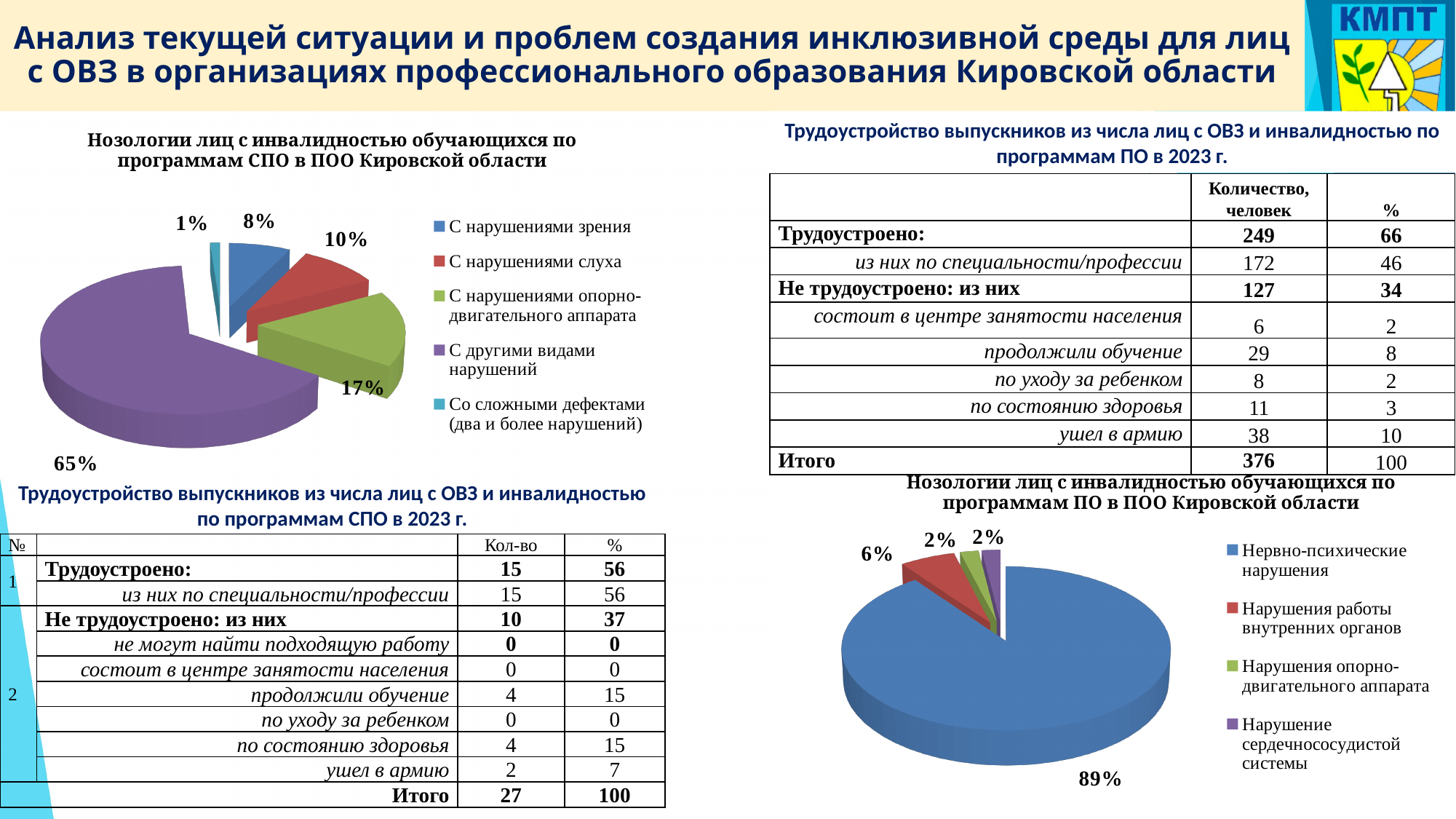
In the pie chart on nosologies of students in СПО programmes (left chart), which category has the largest share? С другими видами нарушений In the pie chart on nosologies of students in ПО programmes (bottom right chart), what share is shown for 'Нарушения работы внутренних органов'? 6% In the pie chart on nosologies of students in СПО programmes (left chart), which is larger: 'С нарушениями слуха' or 'С нарушениями опорно-двигательного аппарата'? С нарушениями опорно-двигательного аппарата In the pie chart on nosologies of students in СПО programmes (left chart), what share is shown for 'С нарушениями опорно-двигательного аппарата'? 17% In the pie chart on nosologies of students in ПО programmes (bottom right chart), what colour is the slice for 'Нервно-психические нарушения'? Blue In the pie chart on nosologies of students with disabilities in СПО programmes (left chart), what share is shown for 'С нарушениями зрения'? 8% In the pie chart on nosologies of students in ПО programmes (bottom right chart), how many categories does the legend list? 4 What type of chart is used for the nosologies of students in ПО programmes (bottom right chart)? Pie chart In the pie chart on nosologies of students in СПО programmes (left chart), what is the difference in percentage points between 'С нарушениями слуха' and 'С нарушениями зрения'? 2 In the pie chart on nosologies of students in СПО programmes (left chart), which category has the smallest share? Со сложными дефектами (два и более нарушений) In the pie chart on nosologies of students in СПО programmes (left chart), how many categories does the legend list? 5 In the pie chart on nosologies of students in ПО programmes (bottom right chart), what share is shown for 'Нервно-психические нарушения'? 89%